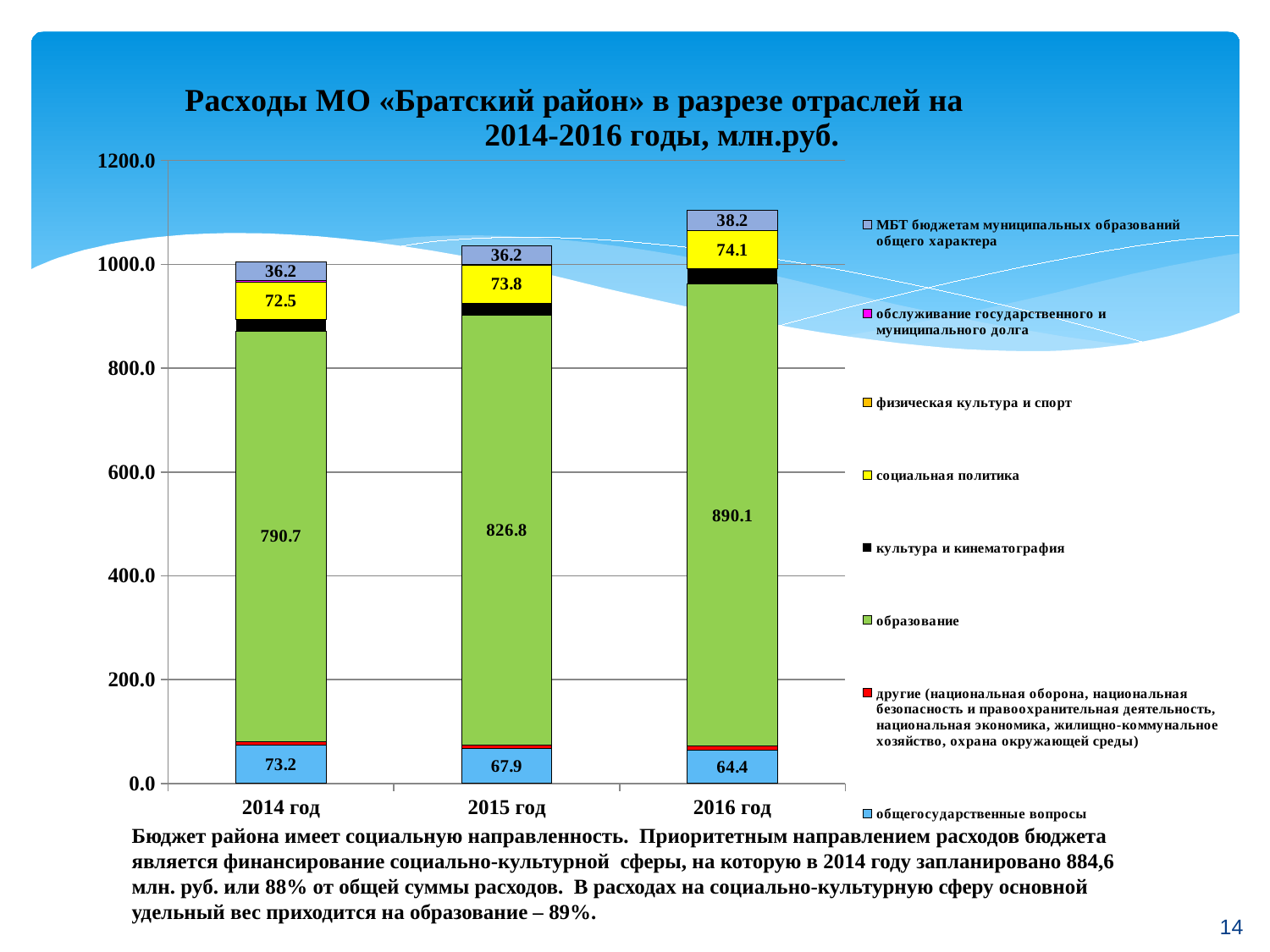
What is the value for общегосударственные вопросы in 2014 год? 73.2 How many series does the legend list? 8 What is the value for образование in 2016 год? 890.1 Is the total height of the stacked bar for 2016 год greater or less than 1000.0? greater What is the value for МБТ бюджетам муниципальных образований общего характера in 2016 год? 38.2 Does the value for образование rise or fall from 2014 год to 2016 год? rises By how much does the value for образование in 2016 год exceed the value in 2014 год? 99.4 Which year has the larger value for социальная политика, 2014 год or 2016 год? 2016 год In which year is the value for образование the highest? 2016 год How many years are shown on the x axis? 3 What is the value for социальная политика in 2015 год? 73.8 In which year is the value for общегосударственные вопросы the lowest? 2016 год